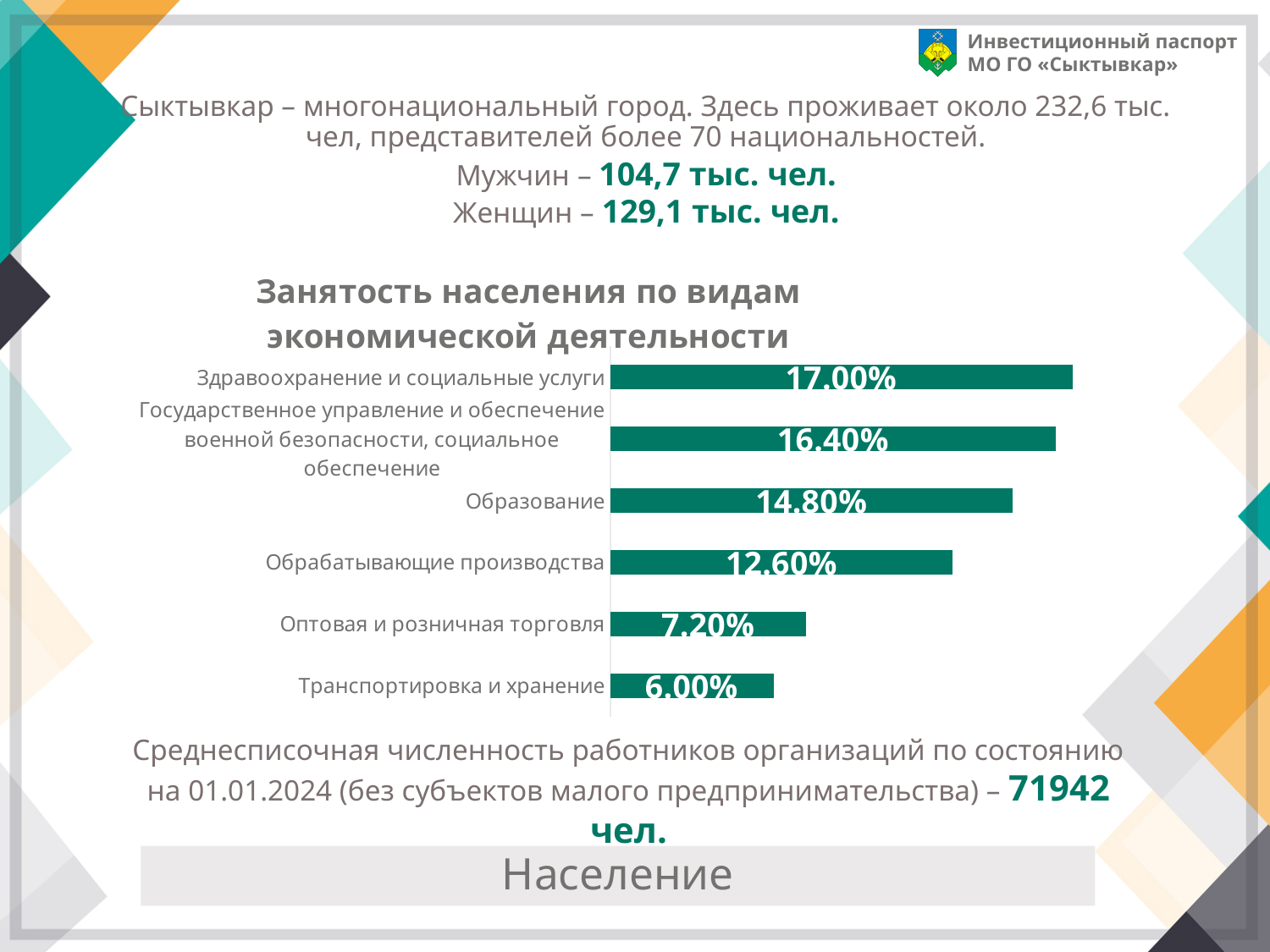
What is the value for Оптовая и розничная торговля? 7.20% How many categories are shown in the chart? 6 What kind of chart is shown on the slide? Bar chart Which category has the lowest value? Транспортировка и хранение What is the value for Образование? 14.80% What is the value for Транспортировка и хранение? 6.00% Which category has the highest value? Здравоохранение и социальные услуги What is the difference between Здравоохранение и социальные услуги and Образование? 2.20% What is the title of the chart? Занятость населения по видам экономической деятельности Which is larger: Образование or Обрабатывающие производства? Образование What is the difference between Обрабатывающие производства and Оптовая и розничная торговля? 5.40% What is the value for Здравоохранение и социальные услуги? 17.00%